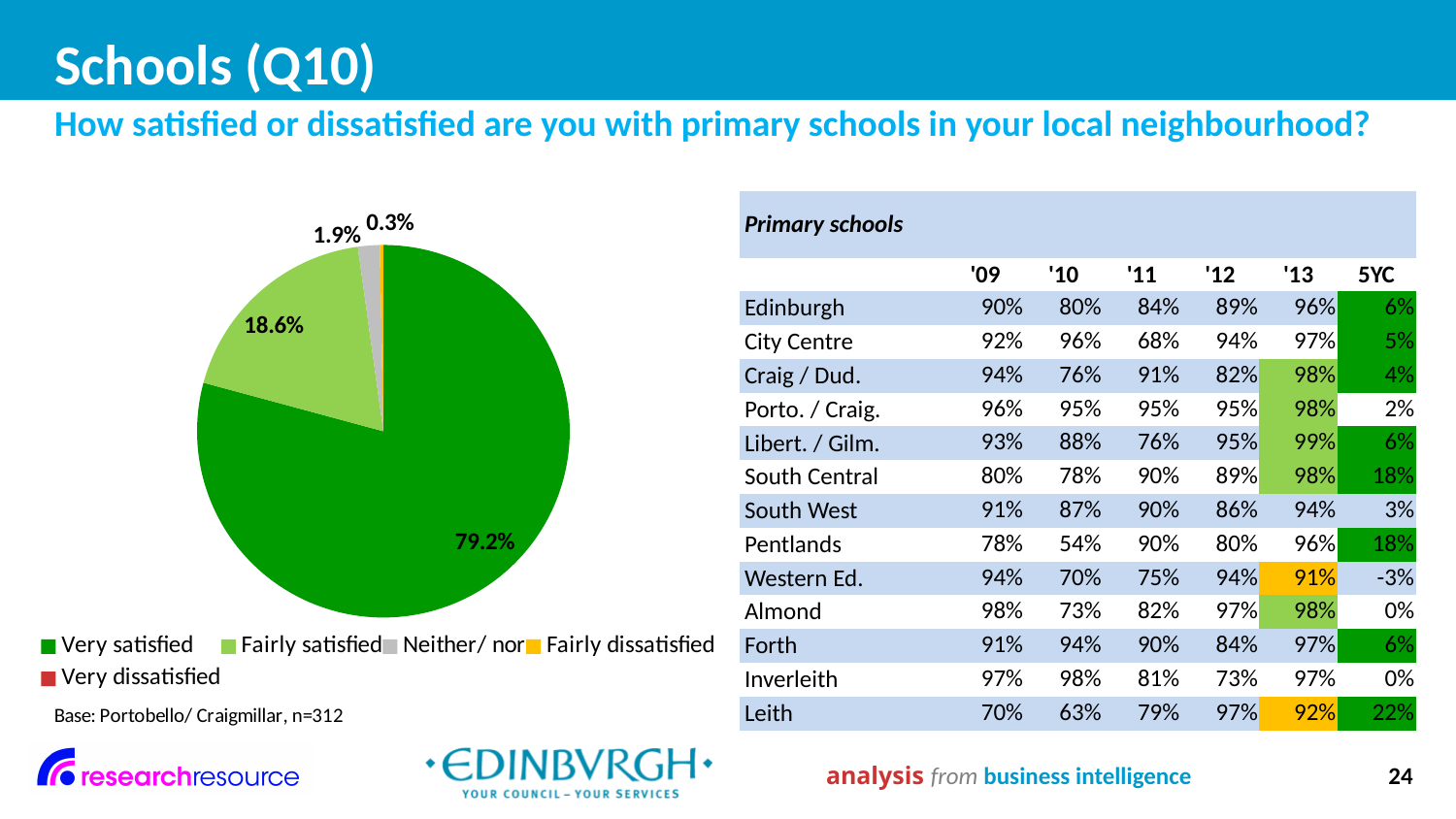
In the pie chart, what percentage is shown for 'Fairly dissatisfied'? 0.3% Which category has the smallest printed value in the pie chart? Fairly dissatisfied Which category has the largest slice in the pie chart? Very satisfied What is the base (sample size) stated below the pie chart? Portobello/ Craigmillar, n=312 In the pie chart, which is larger: 'Fairly satisfied' or 'Neither/ nor'? Fairly satisfied How many categories does the pie chart's legend list? 5 What type of chart is shown on the left of the slide? Pie chart In the pie chart, what is the combined share of 'Very satisfied' and 'Fairly satisfied'? 97.8% In the pie chart, what percentage is shown for 'Neither/ nor'? 1.9% In the pie chart, what percentage of respondents are 'Fairly satisfied'? 18.6% In the pie chart, what percentage of respondents are 'Very satisfied' with primary schools? 79.2% In the pie chart, what is the difference in percentage points between 'Very satisfied' and 'Fairly satisfied'? 60.6 percentage points